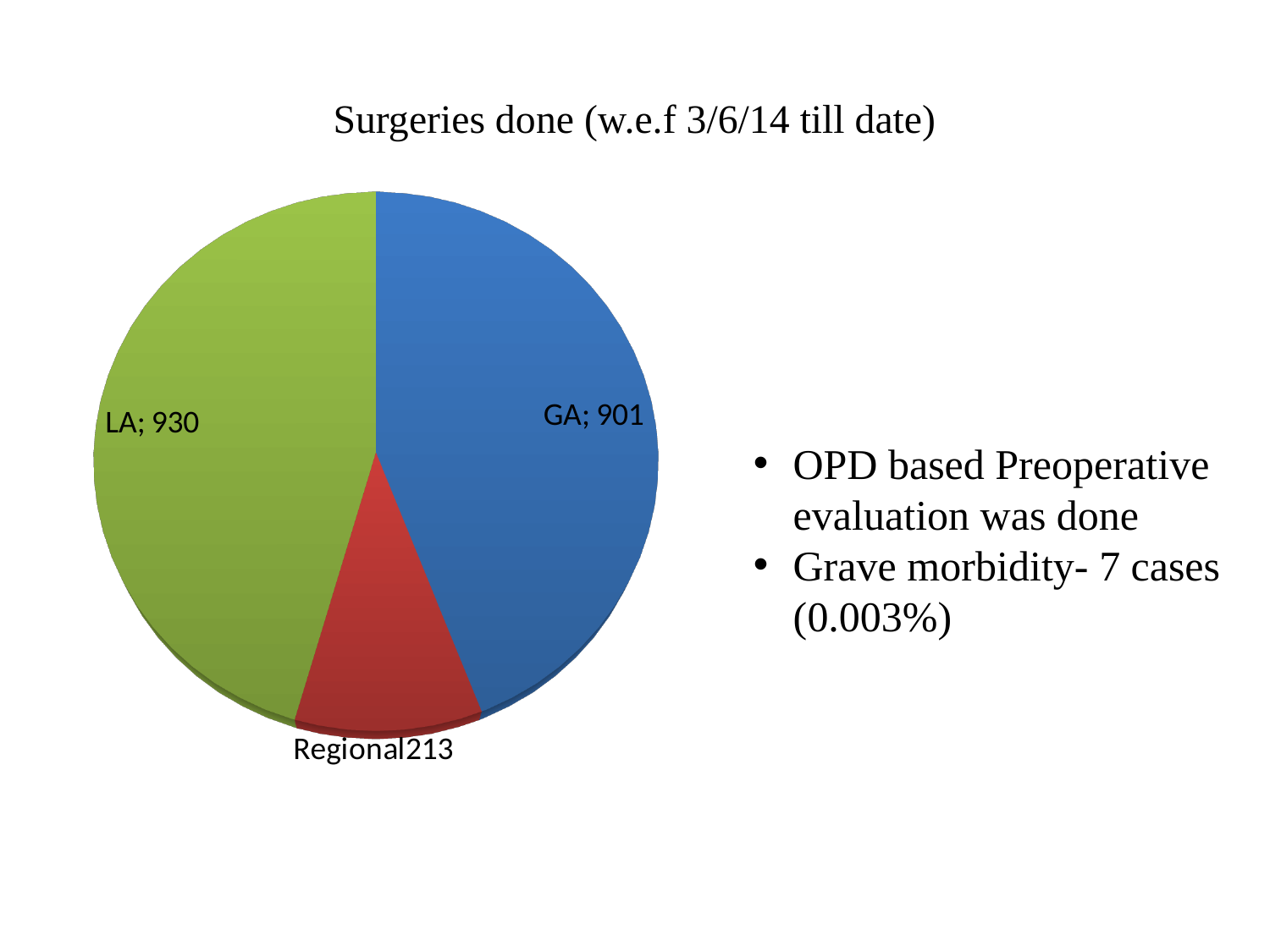
Which category has the largest slice in the pie chart? LA What is the value for LA in the pie chart? 930 How many categories are shown in the pie chart? 3 What is the title of the chart? Surgeries done (w.e.f 3/6/14 till date) What is the value for GA in the pie chart? 901 What is the value for Regional in the pie chart? 213 Which is larger, the value for GA or the value for Regional? GA What is the difference between the GA and Regional values? 688 What is the total of all slices in the pie chart? 2044 What type of chart is shown on the slide? Pie chart Which category has the smallest slice in the pie chart? Regional What is the difference between the LA and GA values? 29